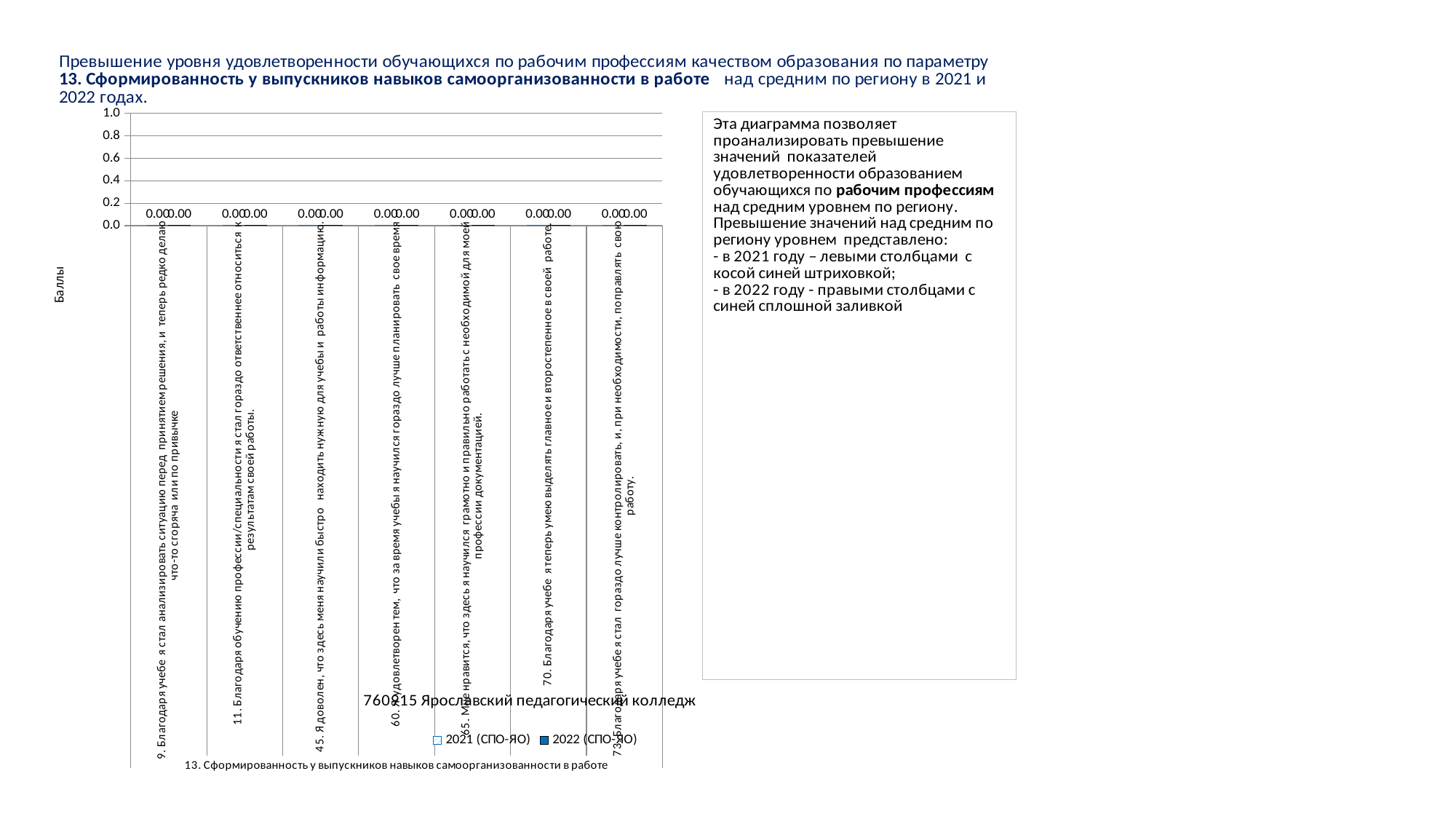
What label is shown on the vertical axis of the chart? Баллы How many categories are shown on the x axis of the chart? 7 What is the value for the 2022 (СПО-ЯО) series for category 70 (Благодаря учебе я теперь умею выделять главное и второстепенное в своей работе)? 0.00 What is the highest value shown on the vertical axis of the chart? 1.0 What is the value for the 2021 (СПО-ЯО) series for category 9 (Благодаря учебе я стал анализировать ситуацию перед принятием решения)? 0.00 What is the value for the 2022 (СПО-ЯО) series for category 73 (Благодаря учебе я стал гораздо лучше контролировать свою работу)? 0.00 What kind of chart is shown on the slide? bar chart What is the value for the 2021 (СПО-ЯО) series for category 45 (Я доволен, что здесь меня научили быстро находить нужную для учебы и работы информацию)? 0.00 What is the difference between the 2021 (СПО-ЯО) and 2022 (СПО-ЯО) values for category 60? 0.00 Is the value for the 2022 (СПО-ЯО) series for category 11 greater or less than 0.2? less How many series does the chart legend list? 2